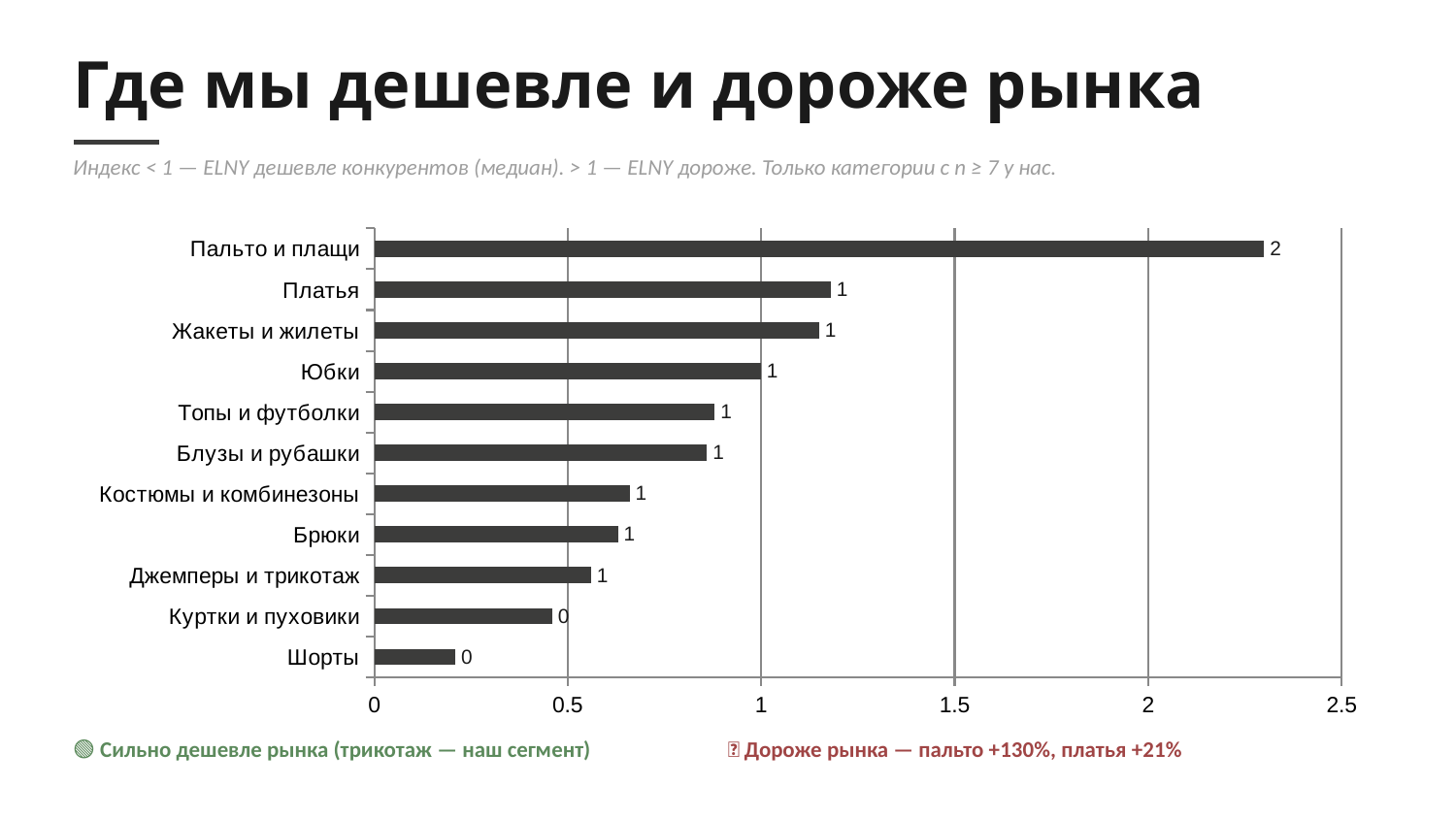
Is the value for Шорты greater or less than 0.5? less What kind of chart is shown on the slide? bar chart How many categories are plotted in the chart? 11 What is the title of the slide containing the chart? Где мы дешевле и дороже рынка What data label is shown for Пальто и плащи? 2 Which is larger, the value for Пальто и плащи or the value for Платья? Пальто и плащи Which category has the highest value in the chart? Пальто и плащи Is the value for Платья greater or less than 1? greater Is the value for Топы и футболки greater or less than 1? less Which category has the lowest value in the chart? Шорты What data label is shown for Шорты? 0